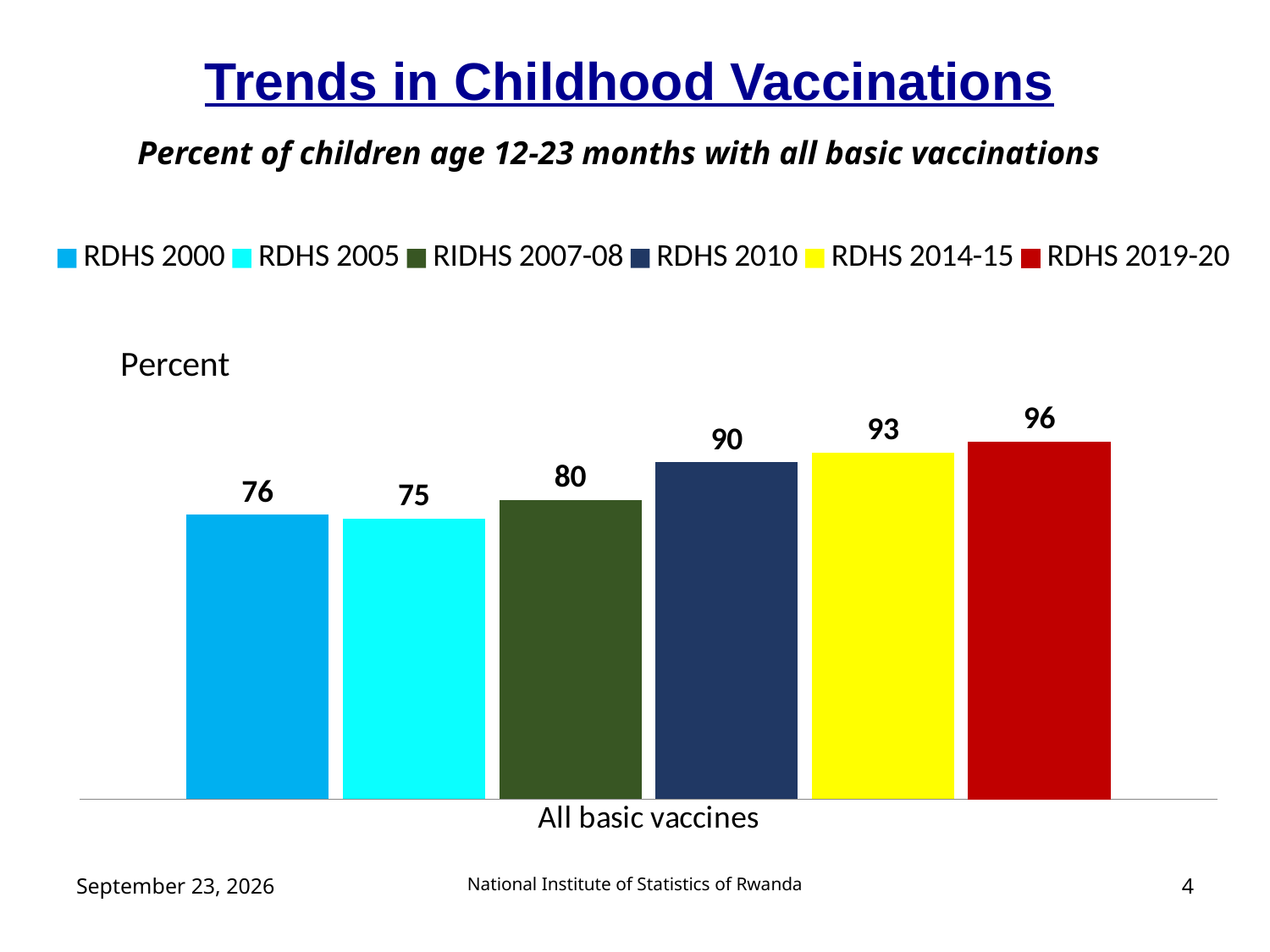
What is the value for RIDHS 2007-08? 80 What is the value for RDHS 2014-15? 93 What is the difference between the RDHS 2010 value and the RIDHS 2007-08 value? 10 What kind of chart is shown on the slide? Bar chart What percent of children age 12-23 months had all basic vaccinations in RDHS 2000? 76 How many series does the legend list? 6 Which is larger, the value for RDHS 2010 or the value for RDHS 2014-15? RDHS 2014-15 What is the value for RDHS 2019-20 for all basic vaccines? 96 What is the title of the chart on the slide? Trends in Childhood Vaccinations Which survey has the highest percent of children with all basic vaccinations? RDHS 2019-20 Which survey has the lowest percent of children with all basic vaccinations? RDHS 2005 What is the difference between the RDHS 2019-20 value and the RDHS 2000 value? 20